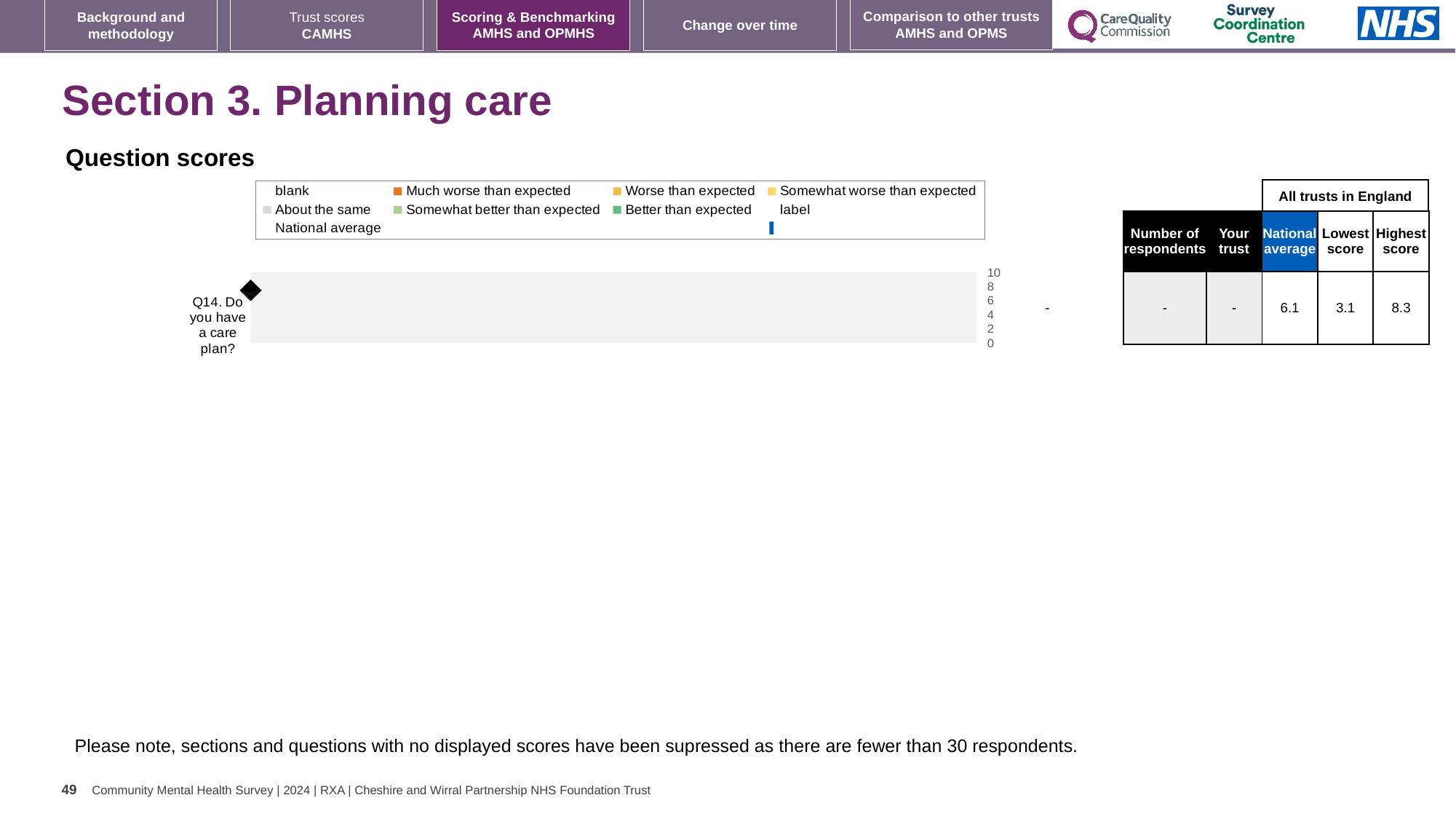
What kind of chart is shown under 'Question scores'? bar chart What is the highest tick value shown on the axis of the Question scores chart? 10 How many questions (categories) are plotted in the Question scores chart? 1 What is the label of the single category on the Question scores chart? Q14. Do you have a care plan? What data label is displayed for Q14 on the Question scores chart? -